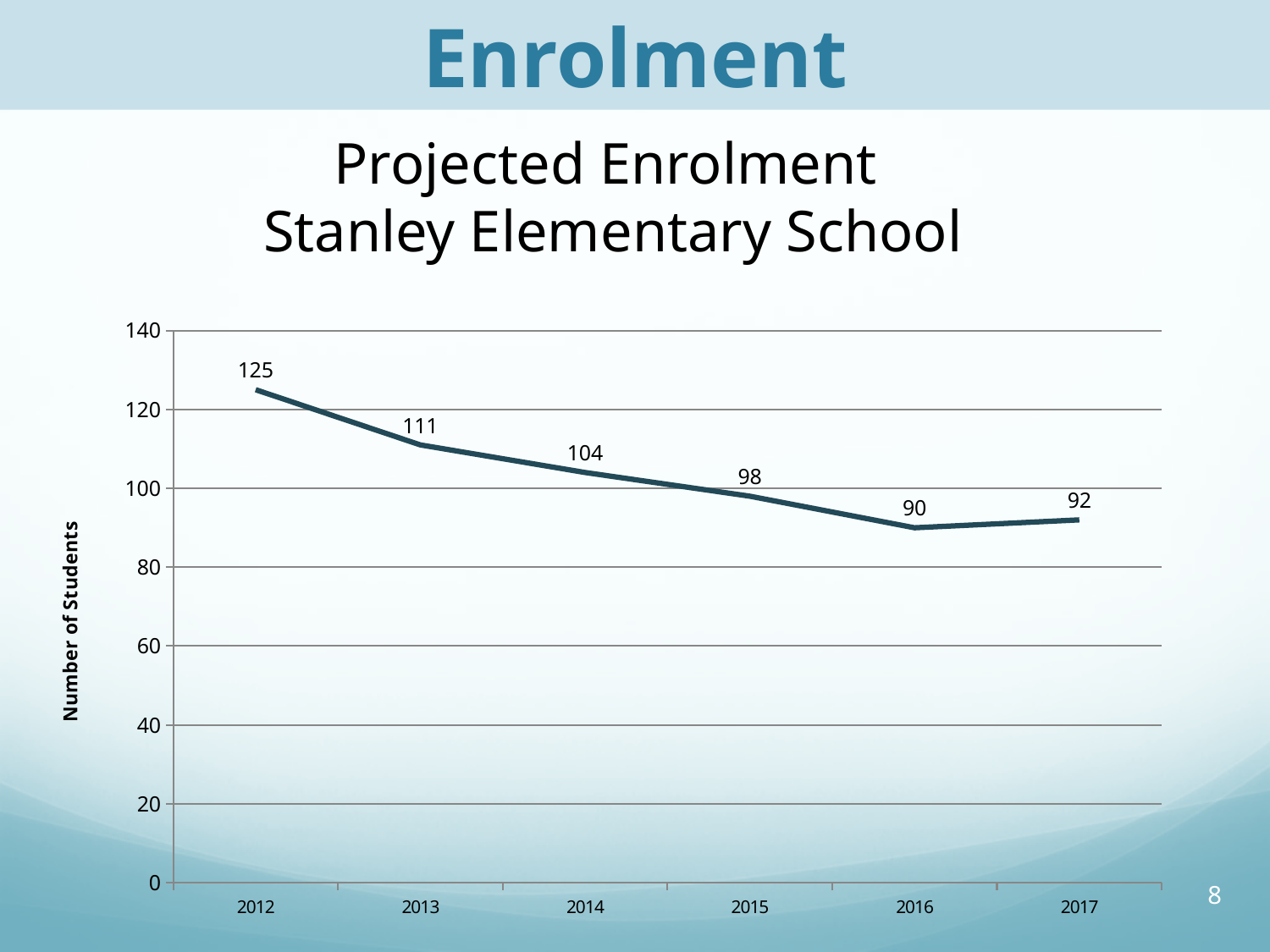
Which year has the highest projected enrolment? 2012 What is the difference in projected enrolment between 2012 and 2013? 14 Which year has the lowest projected enrolment? 2016 What is the projected enrolment for 2017? 92 What is the label of the vertical axis? Number of Students What is the projected enrolment for 2012? 125 What is the difference in projected enrolment between 2014 and 2017? 12 Is the projected enrolment for 2014 greater or less than 100? greater How many years are plotted on the chart? 6 What is the projected enrolment for 2015? 98 What kind of chart is shown on the slide? line chart Which year has a larger projected enrolment, 2016 or 2017? 2017